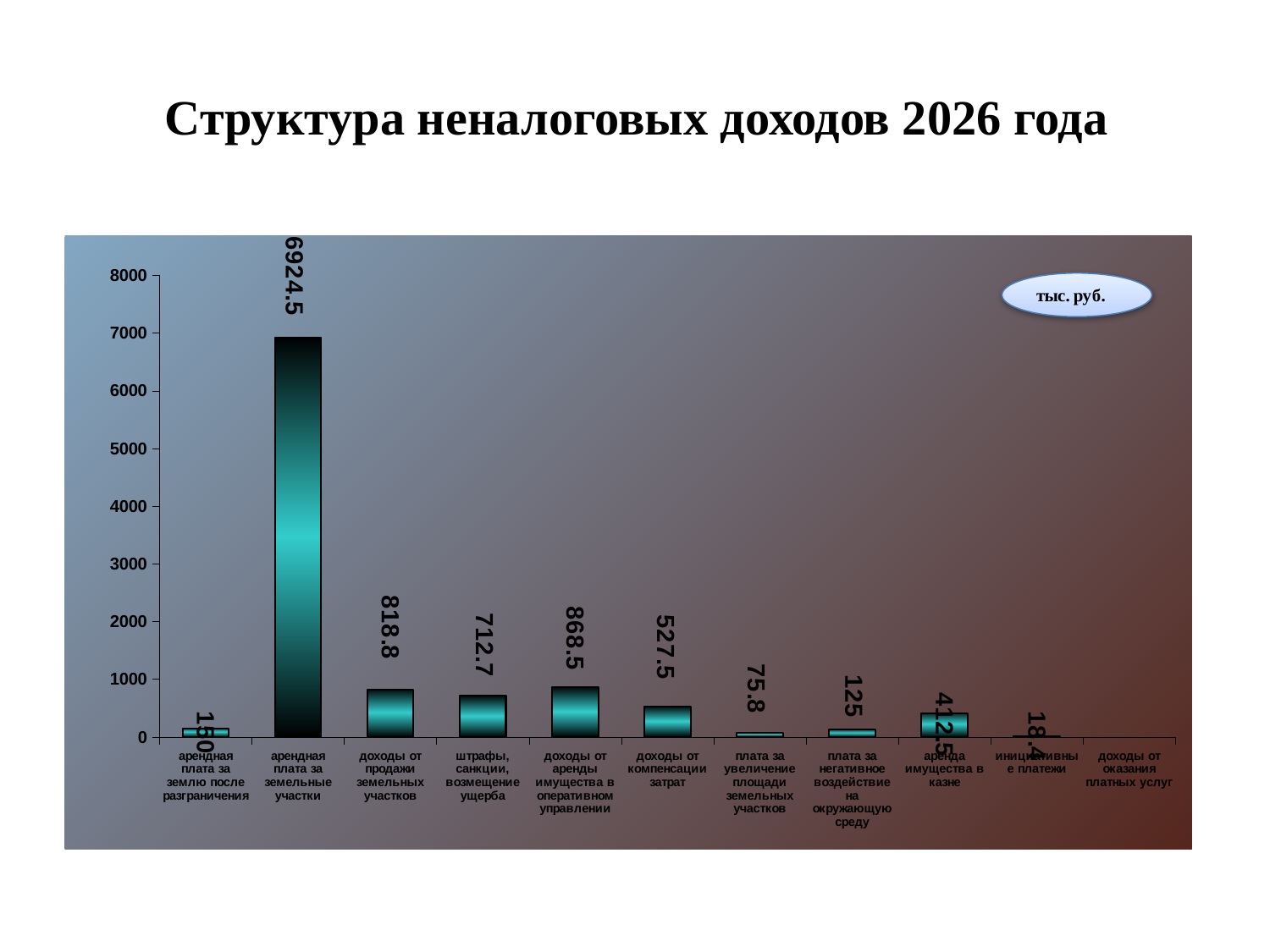
Is the value for 'арендная плата за земельные участки' greater or less than 6000? greater What is the value for 'аренда имущества в казне'? 412.5 Which is larger: 'доходы от компенсации затрат' or 'аренда имущества в казне'? доходы от компенсации затрат What is the difference between 'доходы от аренды имущества в оперативном управлении' and 'доходы от продажи земельных участков'? 49.7 Which category has the highest value? арендная плата за земельные участки What is the value for 'арендная плата за земельные участки'? 6924.5 What unit of measurement is indicated on the chart? тыс. руб. What is the value for 'плата за увеличение площади земельных участков'? 75.8 What is the difference between 'арендная плата за землю после разграничения' and 'плата за негативное воздействие на окружающую среду'? 25 What is the value for 'штрафы, санкции, возмещение ущерба'? 712.7 What kind of chart is shown on the slide? bar chart What is the value for 'доходы от продажи земельных участков'? 818.8